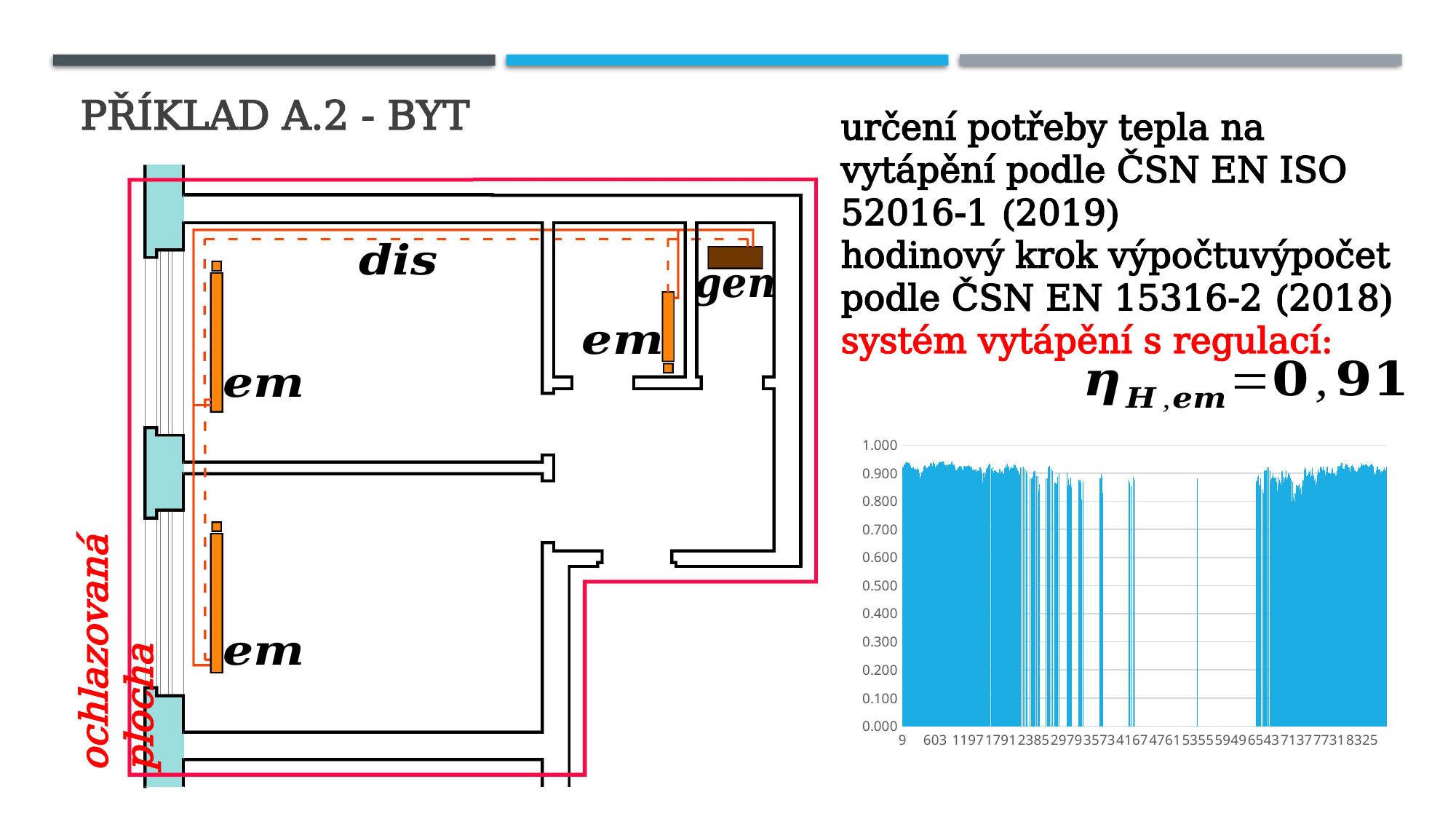
Are the bar values near the start of the chart (around x = 603) greater or less than 1.000? less What kind of chart is shown on the right side of the slide? bar chart What is the highest value labelled on the vertical axis of the chart? 1.000 Are the bar values near the start of the chart (around x = 603) greater or less than 0.500? greater What is the lowest value labelled on the vertical axis of the chart? 0.000 What is the last tick label on the horizontal axis of the chart? 8325 Are the bar values near the end of the chart (around x = 7731) greater or less than 0.800? greater How many tick labels are printed along the horizontal axis of the chart? 15 What is the step between consecutive labels on the vertical axis of the chart? 0.100 What is the first tick label on the horizontal axis of the chart? 9